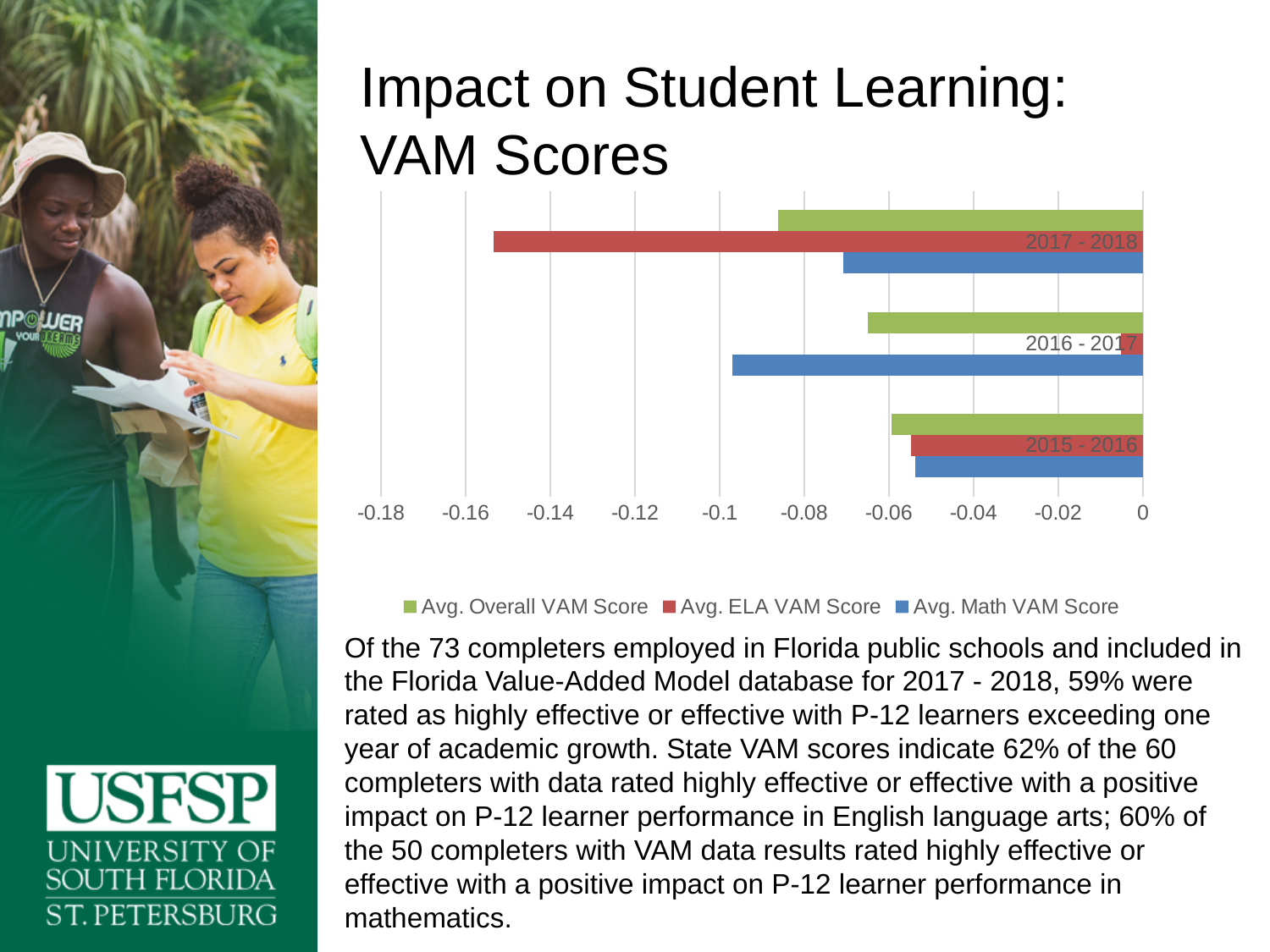
How many year categories are shown on the chart? 3 What kind of chart is shown on the slide? bar chart What is the title of the chart on the slide? Impact on Student Learning: VAM Scores Which is larger, the Avg. ELA VAM Score for 2017 - 2018 or for 2016 - 2017? 2016 - 2017 Is the Avg. ELA VAM Score for 2017 - 2018 greater or less than -0.14? less Which year and series has the highest value (closest to 0) on the chart? Avg. ELA VAM Score, 2016 - 2017 Is the Avg. Math VAM Score for 2017 - 2018 greater or less than -0.08? greater Which year and series has the lowest (most negative) value on the chart? Avg. ELA VAM Score, 2017 - 2018 Which is larger, the Avg. Math VAM Score for 2017 - 2018 or for 2016 - 2017? 2017 - 2018 How many series does the chart legend list? 3 Is the Avg. Math VAM Score for 2016 - 2017 greater or less than -0.08? less Which series is shown in red in the chart? Avg. ELA VAM Score